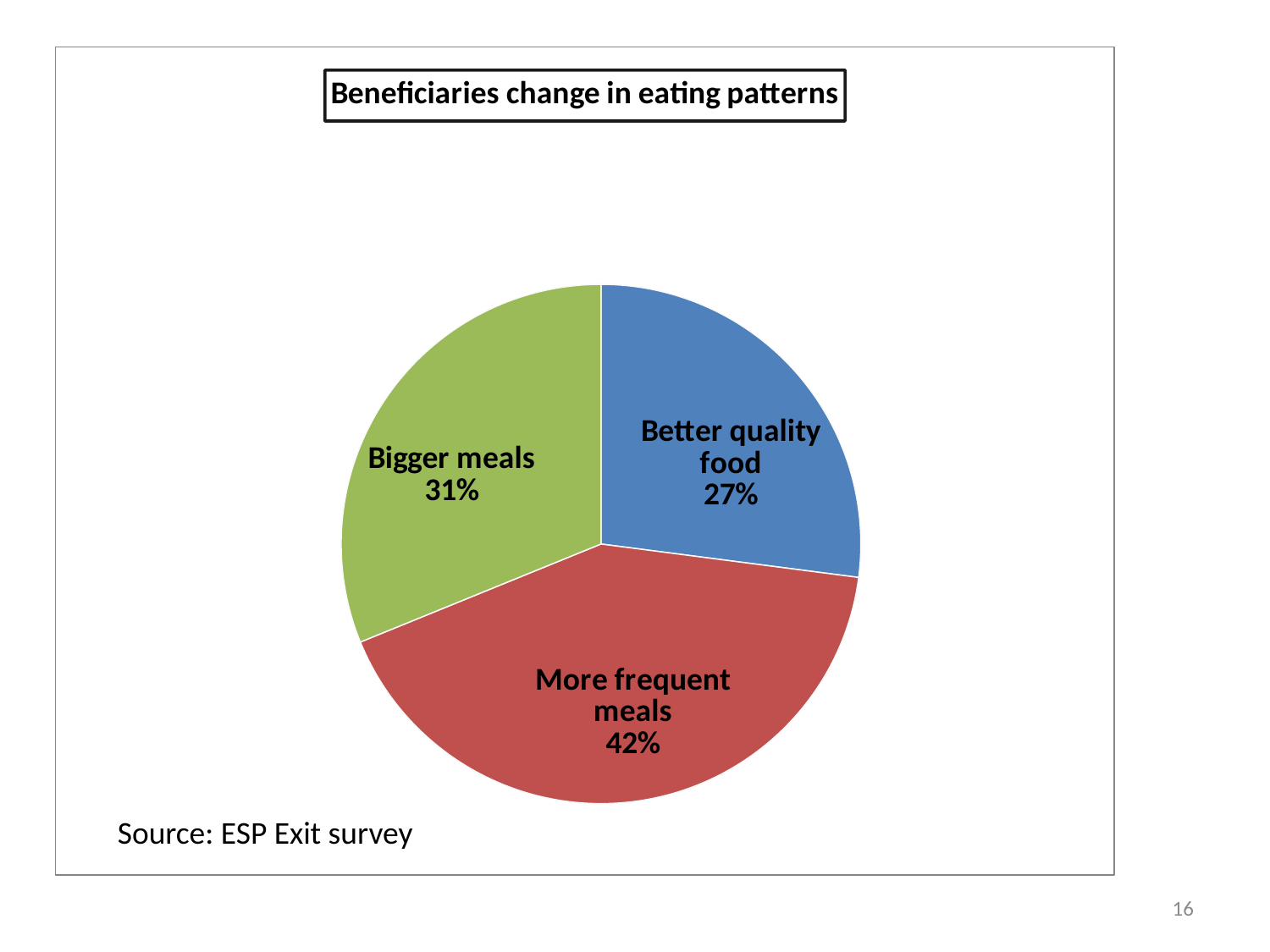
What is the title of the chart? Beneficiaries change in eating patterns Which category has the smallest share of the pie? Better quality food What is the difference in percentage points between 'More frequent meals' and 'Better quality food'? 15 What is the difference in percentage points between 'Bigger meals' and 'Better quality food'? 4 What colour is the 'More frequent meals' slice? red Which is larger, the share for 'Bigger meals' or the share for 'Better quality food'? Bigger meals Which category has the largest share of the pie? More frequent meals What share of the pie is 'Better quality food'? 27% What kind of chart is shown on the slide? pie chart What share of the pie is 'More frequent meals'? 42% What share of the pie is 'Bigger meals'? 31% How many slices does the pie chart have? 3